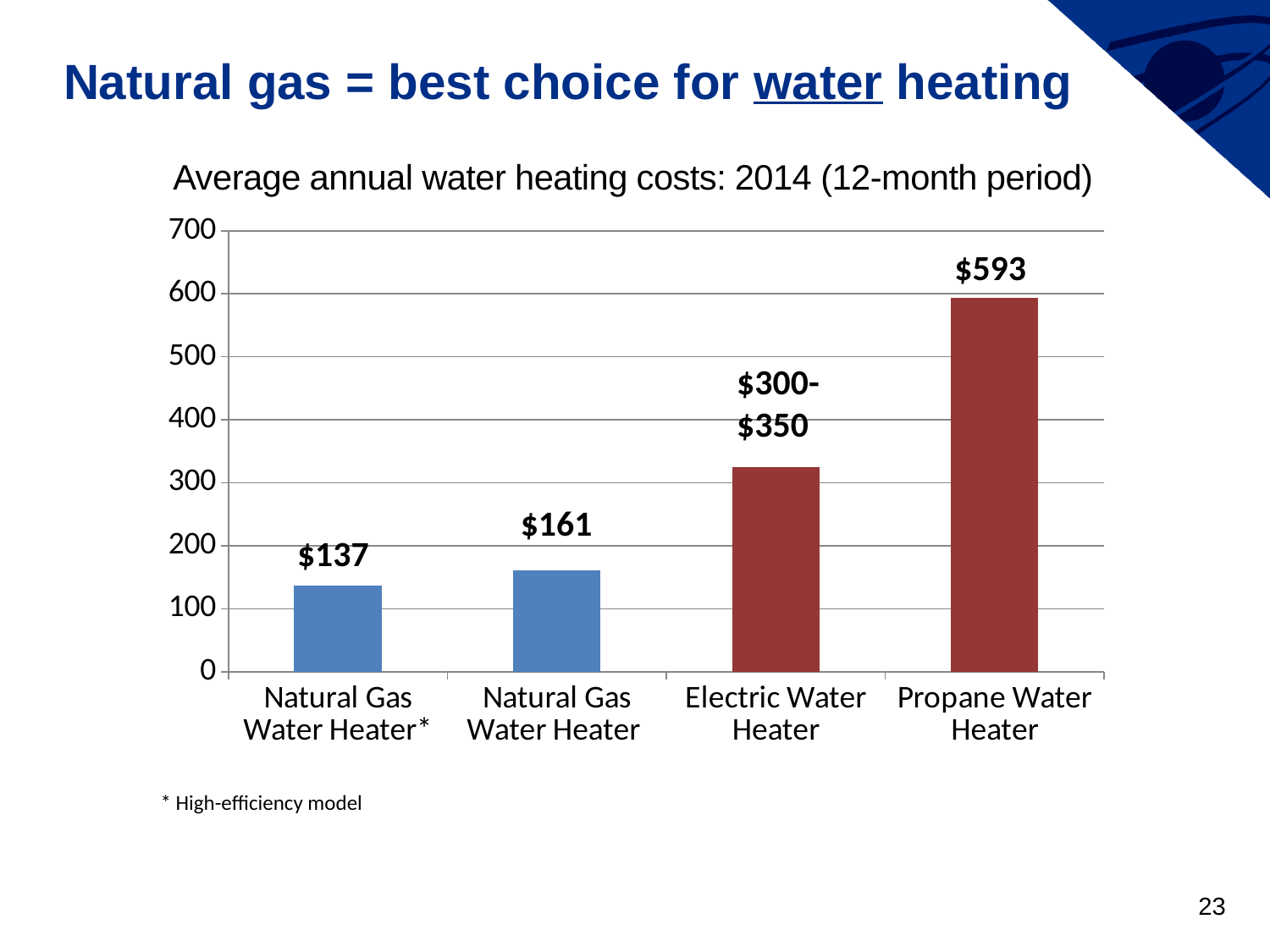
Is the value for the Electric Water Heater greater or less than 400? less Which water heater type has the highest average annual cost? Propane Water Heater What is the difference in annual cost between the Propane Water Heater and the Natural Gas Water Heater? $432 What cost range is labelled for the Electric Water Heater? $300-$350 What is the average annual water heating cost for the Propane Water Heater? $593 What is the average annual water heating cost for the Natural Gas Water Heater* (high-efficiency model)? $137 What type of chart is shown on the slide? Bar chart How many water heater categories are shown on the chart? 4 Which water heater type has the lowest average annual cost? Natural Gas Water Heater* What is the average annual water heating cost for the Natural Gas Water Heater? $161 What is the difference in annual cost between the Natural Gas Water Heater and the high-efficiency Natural Gas Water Heater*? $24 Which has a higher annual cost, the Electric Water Heater or the Propane Water Heater? Propane Water Heater